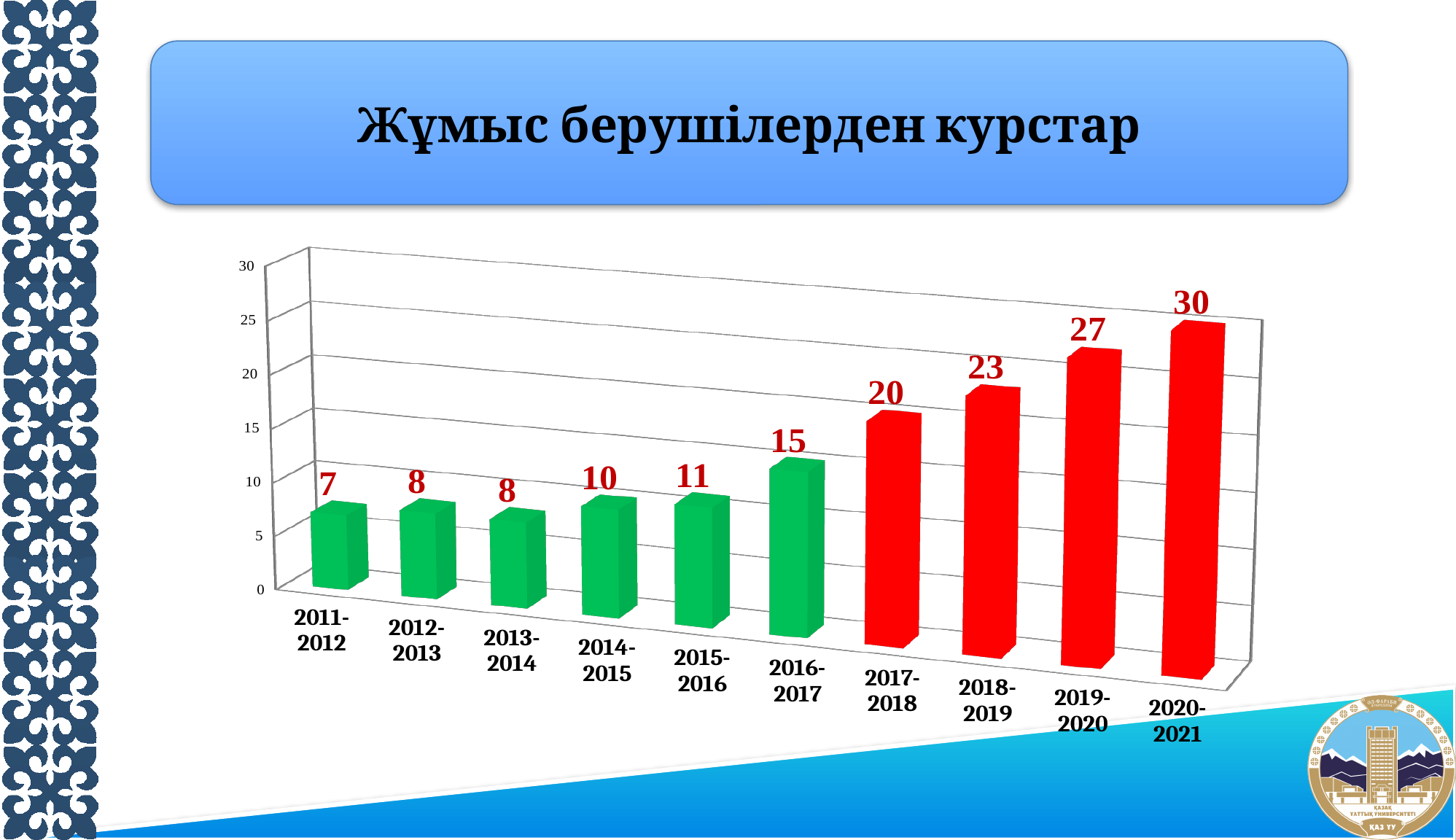
Do the values rise or fall from 2011-2012 to 2020-2021? rise What colour are the bars for 2017-2018 through 2020-2021? red What is the difference between the values for 2020-2021 and 2011-2012? 23 What is the value for 2011-2012? 7 What is the difference between the values for 2017-2018 and 2016-2017? 5 How many academic years are shown on the x axis? 10 Which academic year has the highest value? 2020-2021 Which academic year has the lowest value? 2011-2012 What is the value for 2018-2019? 23 What kind of chart is shown on the slide? bar chart Which is larger, the value for 2014-2015 or the value for 2019-2020? 2019-2020 What is the value for 2016-2017? 15